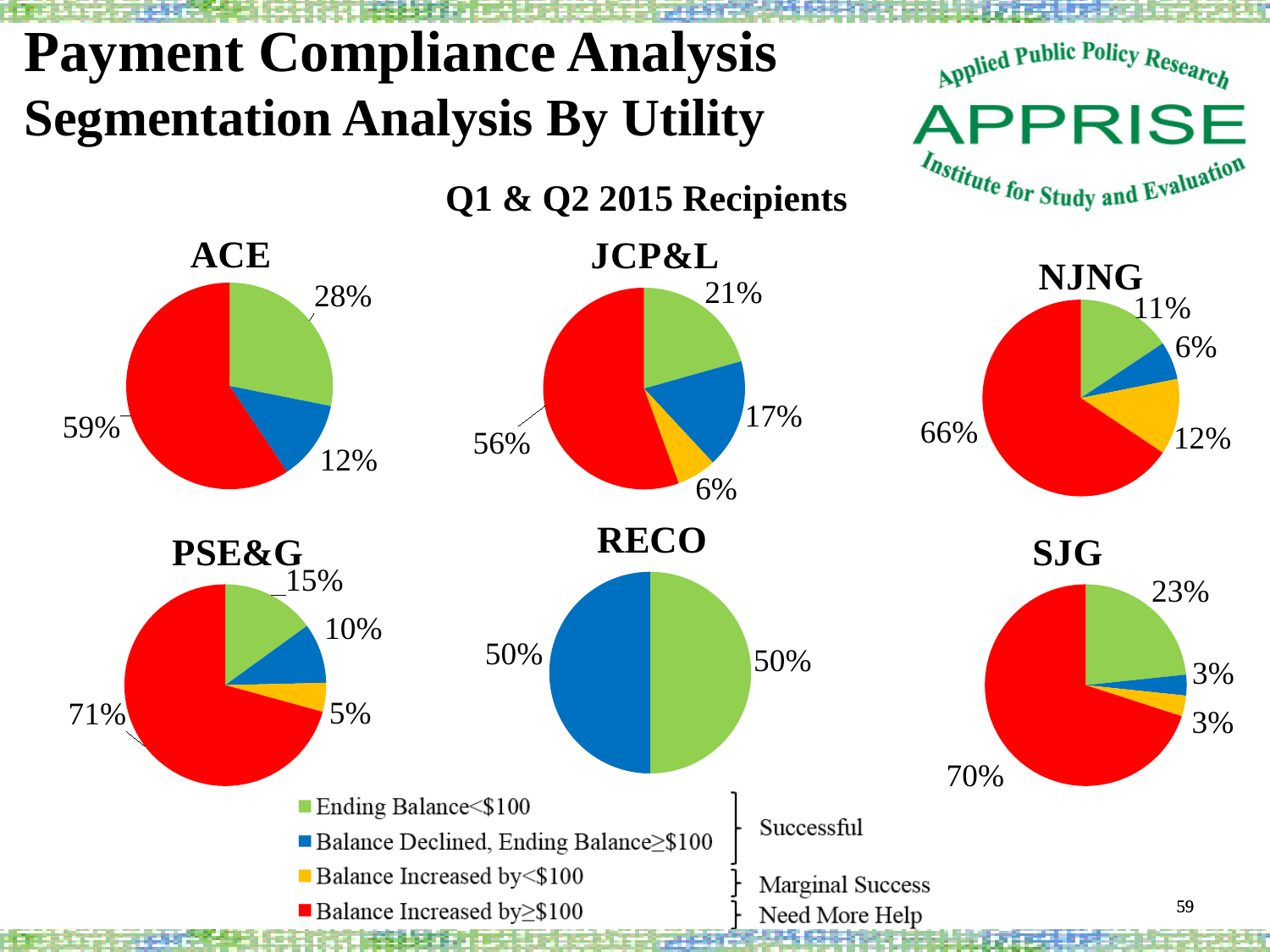
Which is larger: the red slice in the PSE&G pie chart or the red slice in the NJNG pie chart? PSE&G In the ACE pie chart, what share is labelled for the red slice (Balance Increased by≥$100)? 59% In the SJG pie chart, which category has the largest share? Balance Increased by≥$100 What type of chart is used for each utility on this slide? Pie chart In the ACE pie chart, what is the difference between the red slice (59%) and the green slice (28%)? 31% In the PSE&G pie chart, what percentage is shown for the green slice (Ending Balance<$100)? 15% In the JCP&L pie chart, which category has the smallest share? Balance Increased by<$100 In the JCP&L pie chart, what percentage is shown for the blue slice (Balance Declined, Ending Balance≥$100)? 17% How many pie charts are shown on the slide? 6 How many entries does the legend at the bottom of the slide list? 4 In the NJNG pie chart, what percentage is shown for the yellow slice (Balance Increased by<$100)? 12% How many slices does the RECO pie chart have? 2